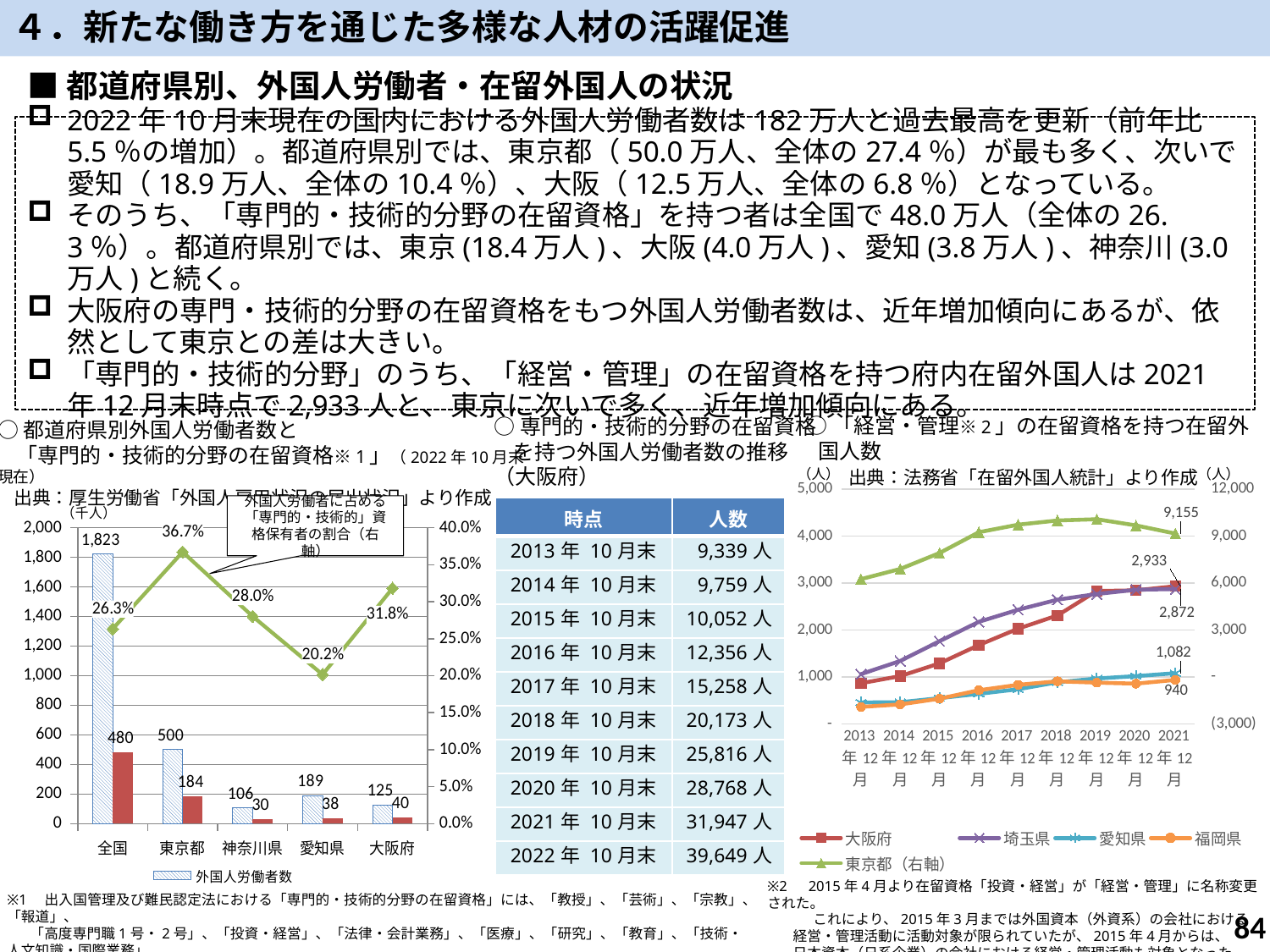
In the left chart (都道府県別外国人労働者数), which prefecture (excluding 全国) has the highest 外国人労働者数? 東京都 In the left chart (都道府県別外国人労働者数), what is the difference between the 外国人労働者数 of 愛知県 and 大阪府? 64 In the left chart (都道府県別外国人労働者数), what percentage is shown on the line for 愛知県? 20.2% In the left chart (都道府県別外国人労働者数), what percentage is shown on the line for 東京都? 36.7% In the left chart (都道府県別外国人労働者数), how many categories are shown on the x axis? 5 In the right chart (「経営・管理」の在留資格を持つ在留外国人数), does the value for 大阪府 rise or fall from 2013年12月 to 2021年12月? rise In the right chart (「経営・管理」の在留資格を持つ在留外国人数), how many series does the legend list? 5 In the left chart (都道府県別外国人労働者数), what is the value of 外国人労働者数 for 東京都? 500 In the right chart (「経営・管理」の在留資格を持つ在留外国人数), what is the value for 東京都 in 2021年12月? 9,155 In the left chart (都道府県別外国人労働者数), what is the value of 外国人労働者数 for 全国? 1,823 In the right chart (「経営・管理」の在留資格を持つ在留外国人数), what is the value for 大阪府 in 2021年12月? 2,933 In the left chart (都道府県別外国人労働者数), which category has the lowest percentage on the line? 愛知県